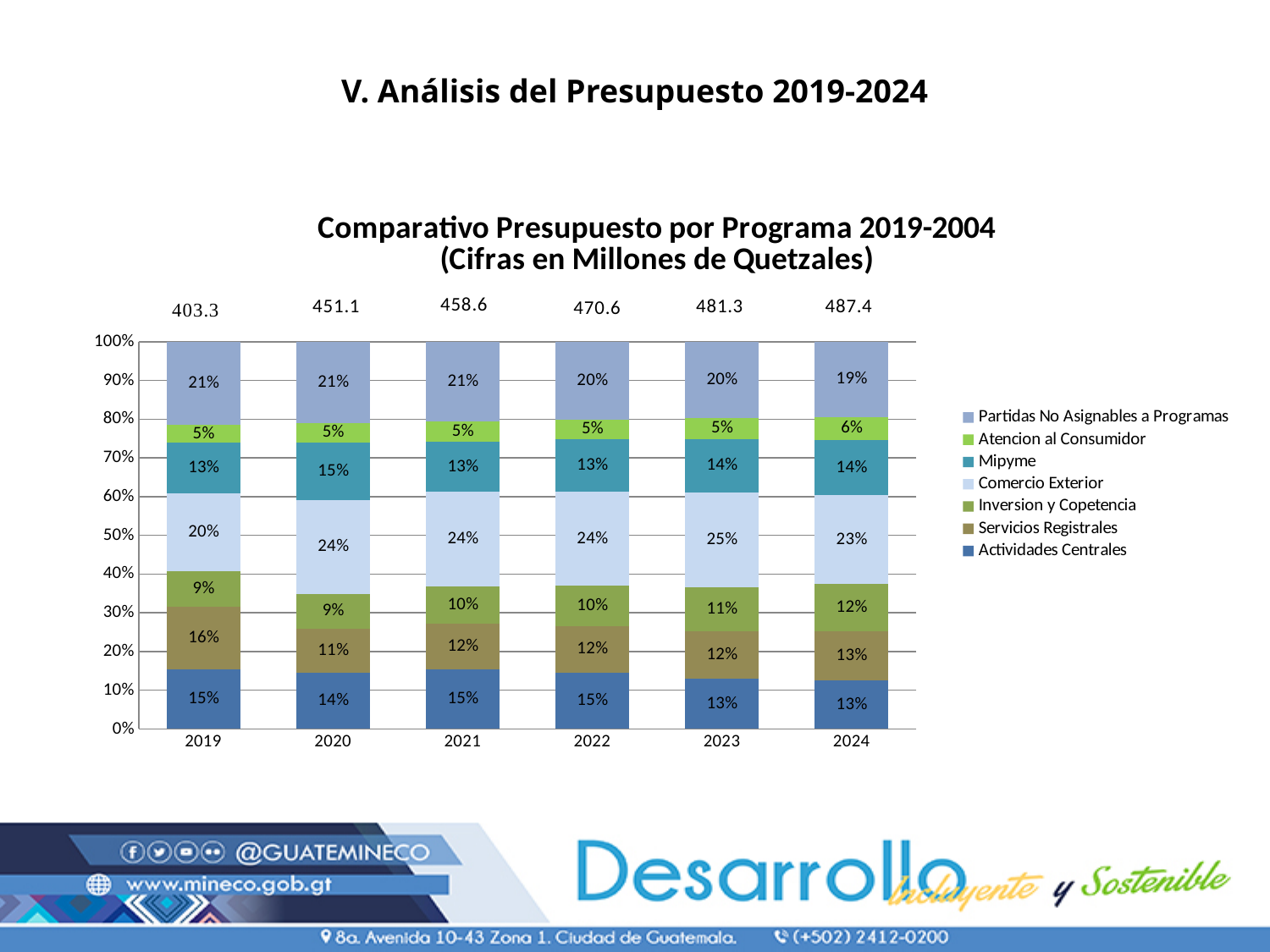
Which year has the lowest total value printed above its bar? 2019 What total value is printed above the 2019 bar? 403.3 How many series does the legend list? 7 What is the share of Mipyme in 2020? 15% What total value is printed above the 2024 bar? 487.4 What percentage does Comercio Exterior represent in 2019? 20% What percentage is shown for Actividades Centrales in 2024? 13% Which year has the highest total value printed above its bar? 2024 What is the share of Partidas No Asignables a Programas in 2024? 19% Is the Servicios Registrales share larger in 2019 or in 2020? 2019 By how many percentage points does the Comercio Exterior share in 2020 exceed that in 2019? 4 percentage points Do the total values printed above the bars rise or fall from 2019 to 2024? Rise